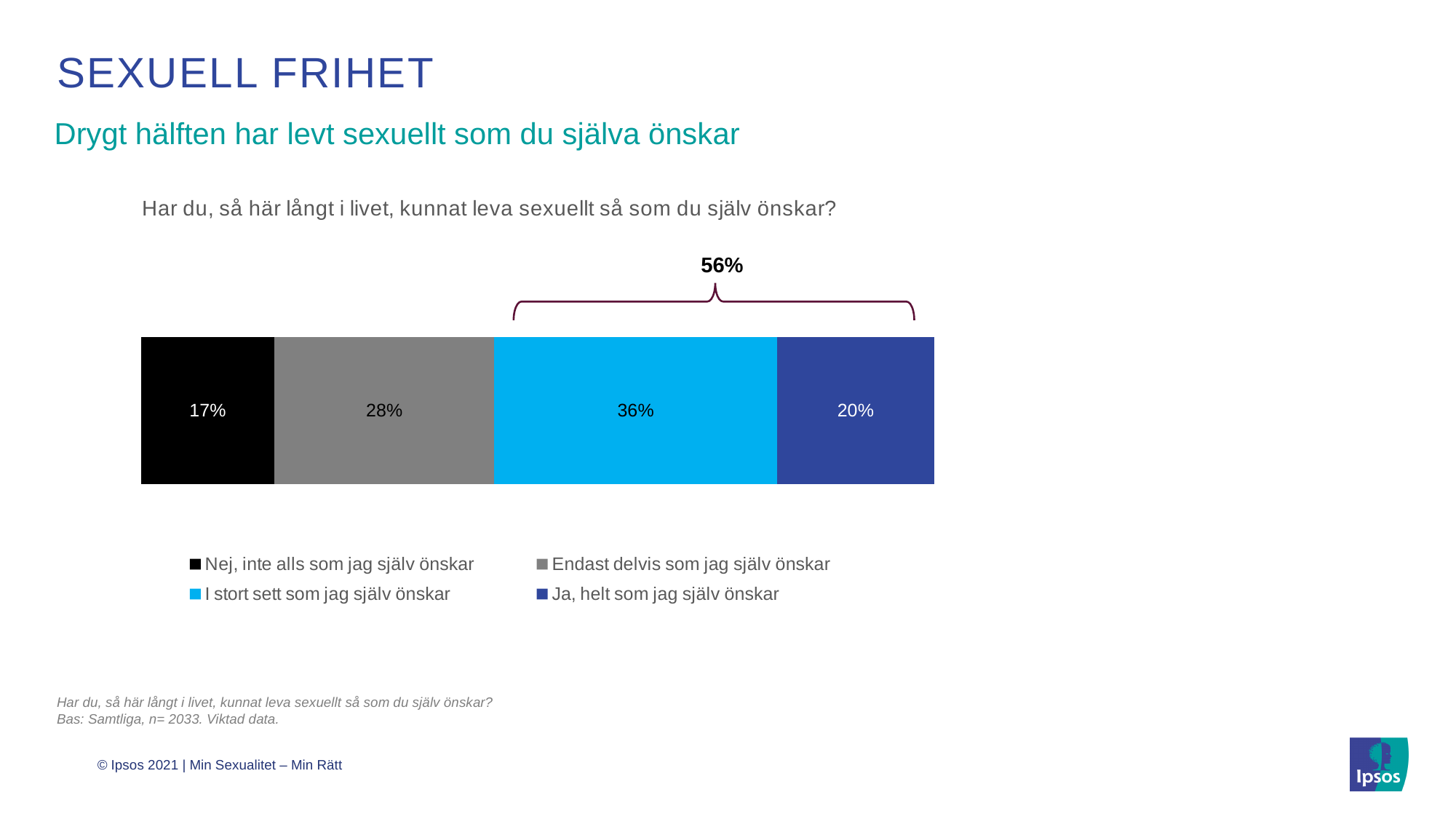
What combined percentage is shown by the bracket above the two rightmost segments? 56% What percentage of respondents answered "Ja, helt som jag själv önskar"? 20% What kind of chart is shown on the slide? Stacked bar chart What percentage of respondents answered "Nej, inte alls som jag själv önskar"? 17% Which is larger: the share for "Endast delvis som jag själv önskar" or for "Ja, helt som jag själv önskar"? Endast delvis som jag själv önskar Which response category has the largest share? I stort sett som jag själv önskar What is the difference in percentage points between "I stort sett som jag själv önskar" and "Ja, helt som jag själv önskar"? 16 What percentage of respondents answered "I stort sett som jag själv önskar"? 36% Which response category has the smallest share? Nej, inte alls som jag själv önskar How many response categories does the legend list? 4 What percentage of respondents answered "Endast delvis som jag själv önskar"? 28% What colour is the segment for "Nej, inte alls som jag själv önskar"? Black